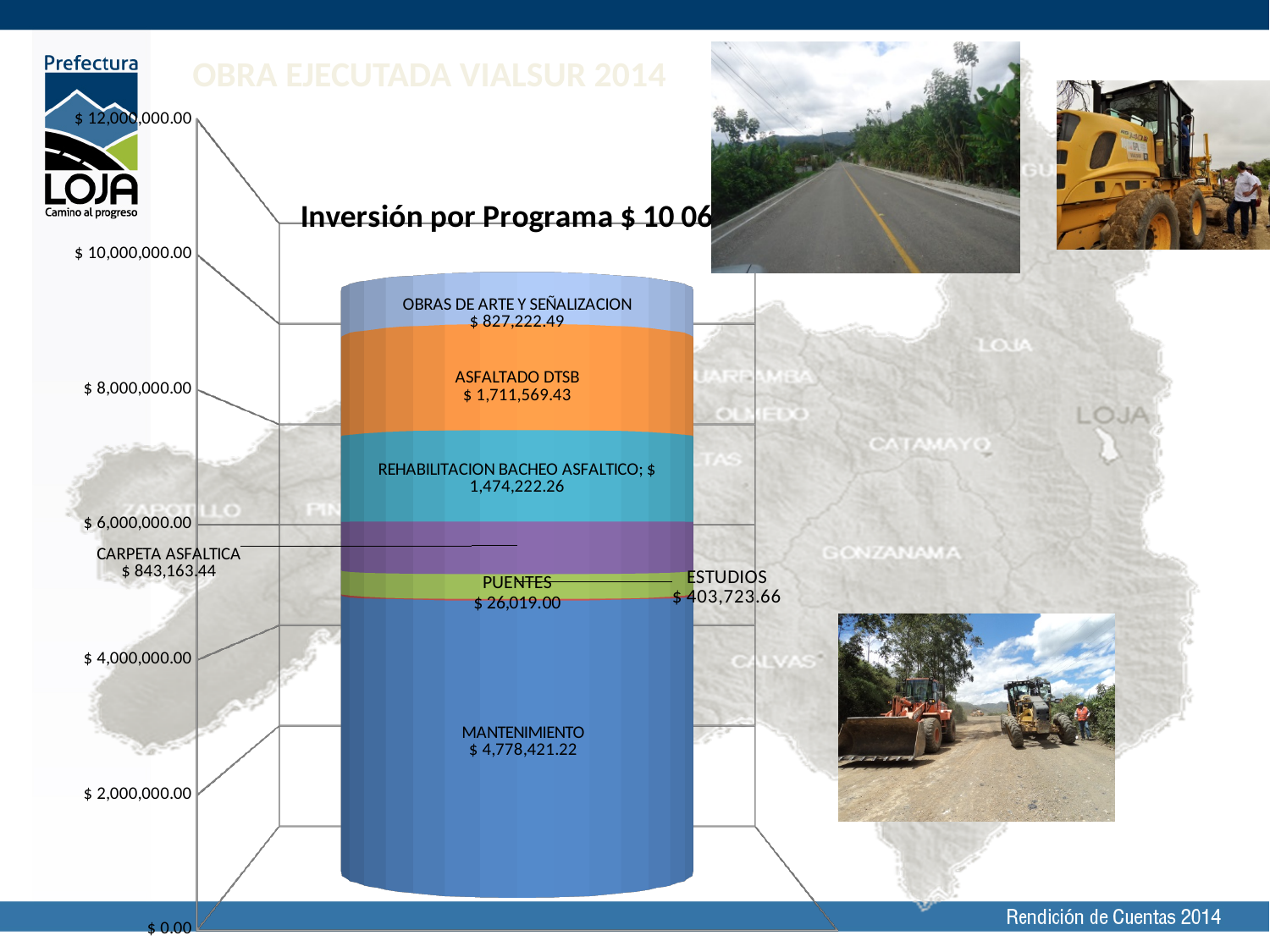
What is the difference between ASFALTADO DTSB and REHABILITACION BACHEO ASFALTICO? $ 237,347.17 Is the total height of the stacked bar greater or less than $ 8,000,000.00? greater What is the value for ASFALTADO DTSB? $ 1,711,569.43 What is the value for OBRAS DE ARTE Y SEÑALIZACION? $ 827,222.49 Which is larger, CARPETA ASFALTICA or OBRAS DE ARTE Y SEÑALIZACION? CARPETA ASFALTICA What is the value for MANTENIMIENTO in the stacked bar chart? $ 4,778,421.22 What is the value for ESTUDIOS? $ 403,723.66 Which program has the smallest investment in the chart? PUENTES What is the total of all segments in the stacked bar? $ 10,064,341.50 What kind of chart is shown on the slide? stacked bar chart How many program segments make up the stacked bar? 7 Which program has the largest investment in the chart? MANTENIMIENTO